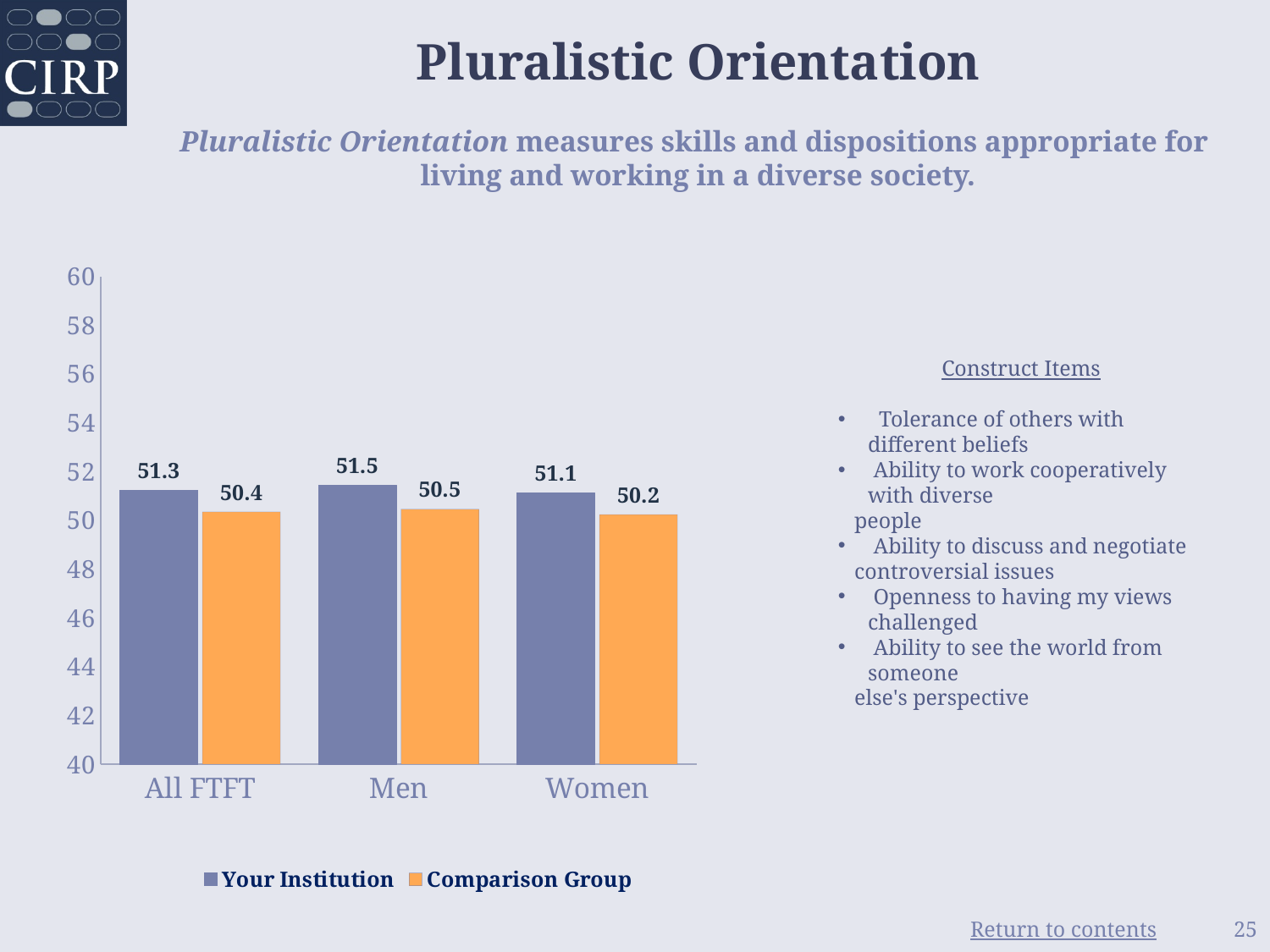
What kind of chart is shown on the slide? Bar chart What is the Your Institution value for Men? 51.5 What is the difference between the Your Institution and Comparison Group values for All FTFT? 0.9 What is the difference between the Your Institution values for Men and Women? 0.4 Which category has the highest Your Institution value? Men Which category has the lowest Comparison Group value? Women Which series is shown in orange in the legend? Comparison Group Which is larger for Women: Your Institution or Comparison Group? Your Institution What is the Comparison Group value for Women? 50.2 How many categories are shown on the x axis? 3 How many series does the legend list? 2 What is the Your Institution value for All FTFT? 51.3